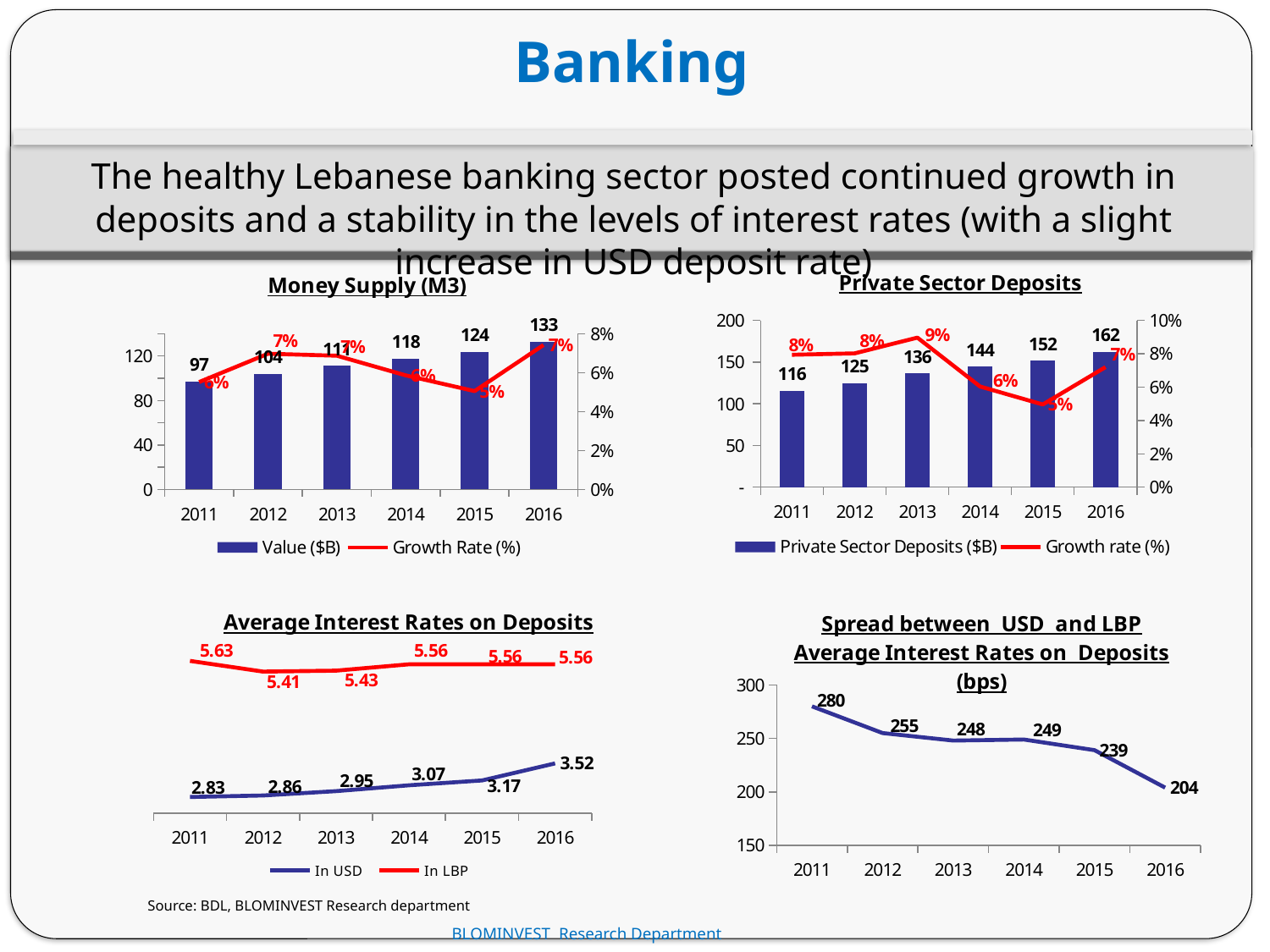
In the Average Interest Rates on Deposits chart, what is the rate in LBP for 2012? 5.41 In the Average Interest Rates on Deposits chart, what is the rate in USD for 2016? 3.52 What kind of chart is the Spread between USD and LBP Average Interest Rates on Deposits chart? line chart In the Private Sector Deposits chart, what is the value of private sector deposits for 2014? 144 In the Spread between USD and LBP Average Interest Rates on Deposits chart, which year has the lowest spread? 2016 In the Private Sector Deposits chart, how many series does the legend list? 2 In the Money Supply (M3) chart, what is the difference between the 2016 and 2011 values? 36 In the Money Supply (M3) chart, what is the value for 2016? 133 In the Private Sector Deposits chart, what is the growth rate for 2013? 9% In the Private Sector Deposits chart, which year has the highest private sector deposits? 2016 In the Spread between USD and LBP Average Interest Rates on Deposits chart, what is the value for 2011? 280 In the Average Interest Rates on Deposits chart, do the USD rates rise or fall from 2011 to 2016? rise